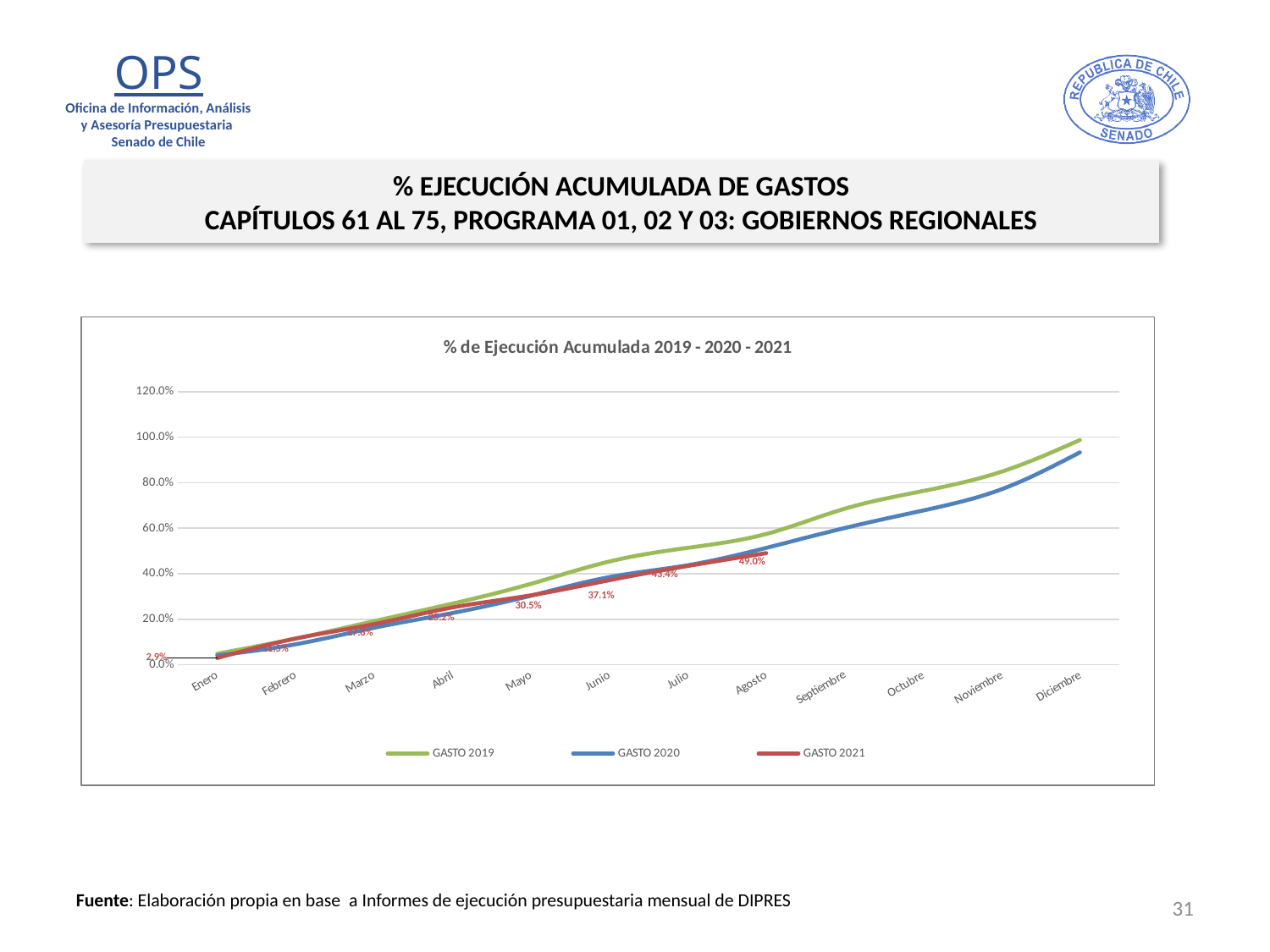
Is the value for GASTO 2020 in Diciembre greater or less than 80.0%? greater What is the difference between the GASTO 2021 values for Agosto and Julio? 5.6% Do the values for GASTO 2019 rise or fall from Enero to Diciembre? rise What kind of chart is shown on the slide? line chart What is the value for GASTO 2021 in Agosto? 49.0% What is the value for GASTO 2021 in Julio? 43.4% What is the value for GASTO 2021 in Enero? 2.9% How many months are shown along the x axis? 12 How many series does the legend list? 3 What is the value for GASTO 2021 in Junio? 37.1% What is the value for GASTO 2021 in Mayo? 30.5% In Diciembre, which series is higher, GASTO 2019 or GASTO 2020? GASTO 2019